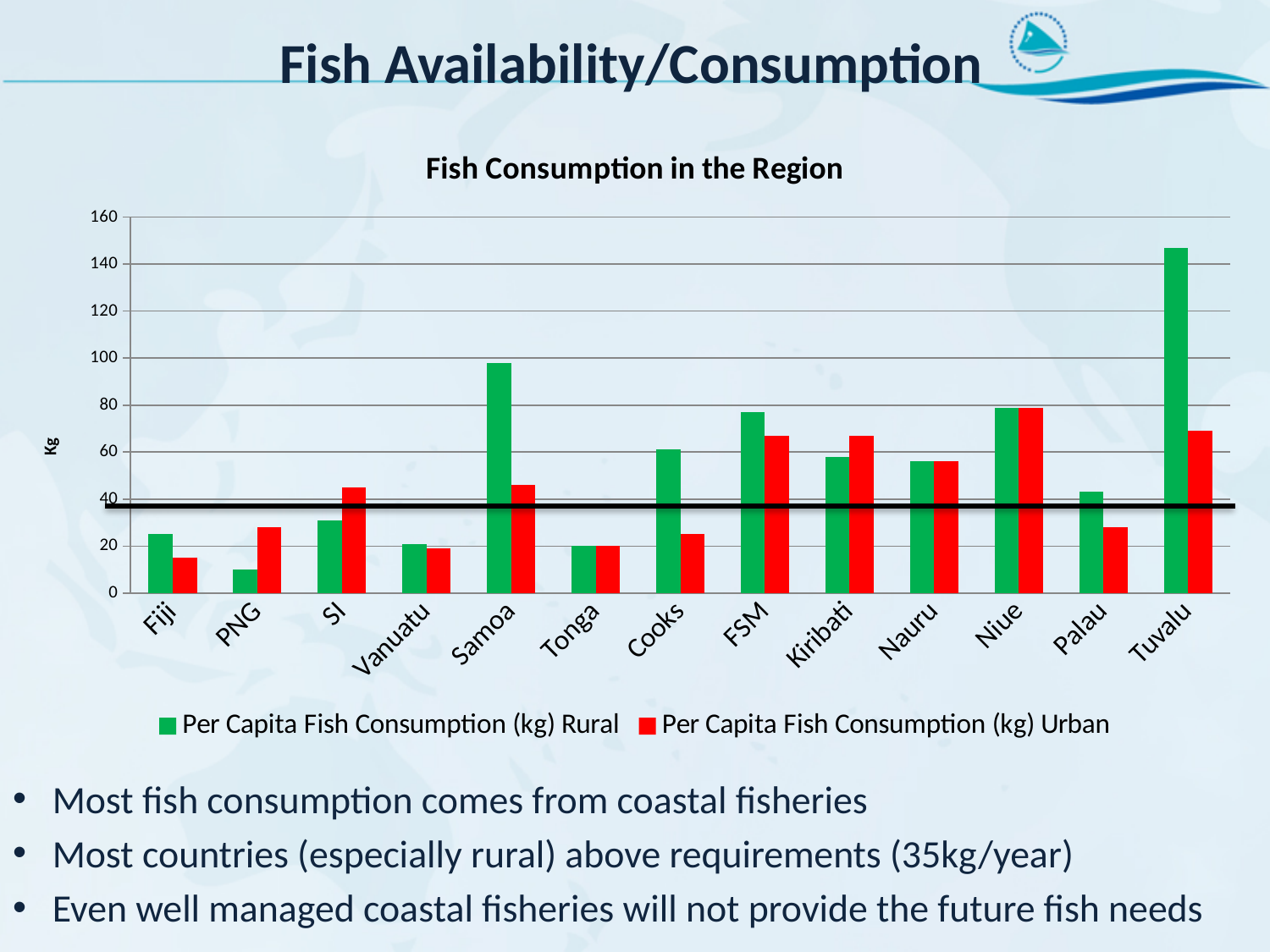
Which country has the highest Per Capita Fish Consumption (kg) Urban? Niue How many countries are shown on the x axis of the chart? 13 Is the Per Capita Fish Consumption (kg) Urban value for Fiji greater or less than 20? less Is the Per Capita Fish Consumption (kg) Rural value for Samoa greater or less than 80? greater Which country has the highest Per Capita Fish Consumption (kg) Rural? Tuvalu Which country has the lowest Per Capita Fish Consumption (kg) Rural? PNG For Samoa, which is larger: the Rural or the Urban per capita fish consumption? Rural For Kiribati, which is larger: the Rural or the Urban per capita fish consumption? Urban How many series does the chart's legend list? 2 Is the Per Capita Fish Consumption (kg) Rural value for Tuvalu greater or less than 140? greater What is the title of the chart? Fish Consumption in the Region What kind of chart is shown on the slide? Bar chart